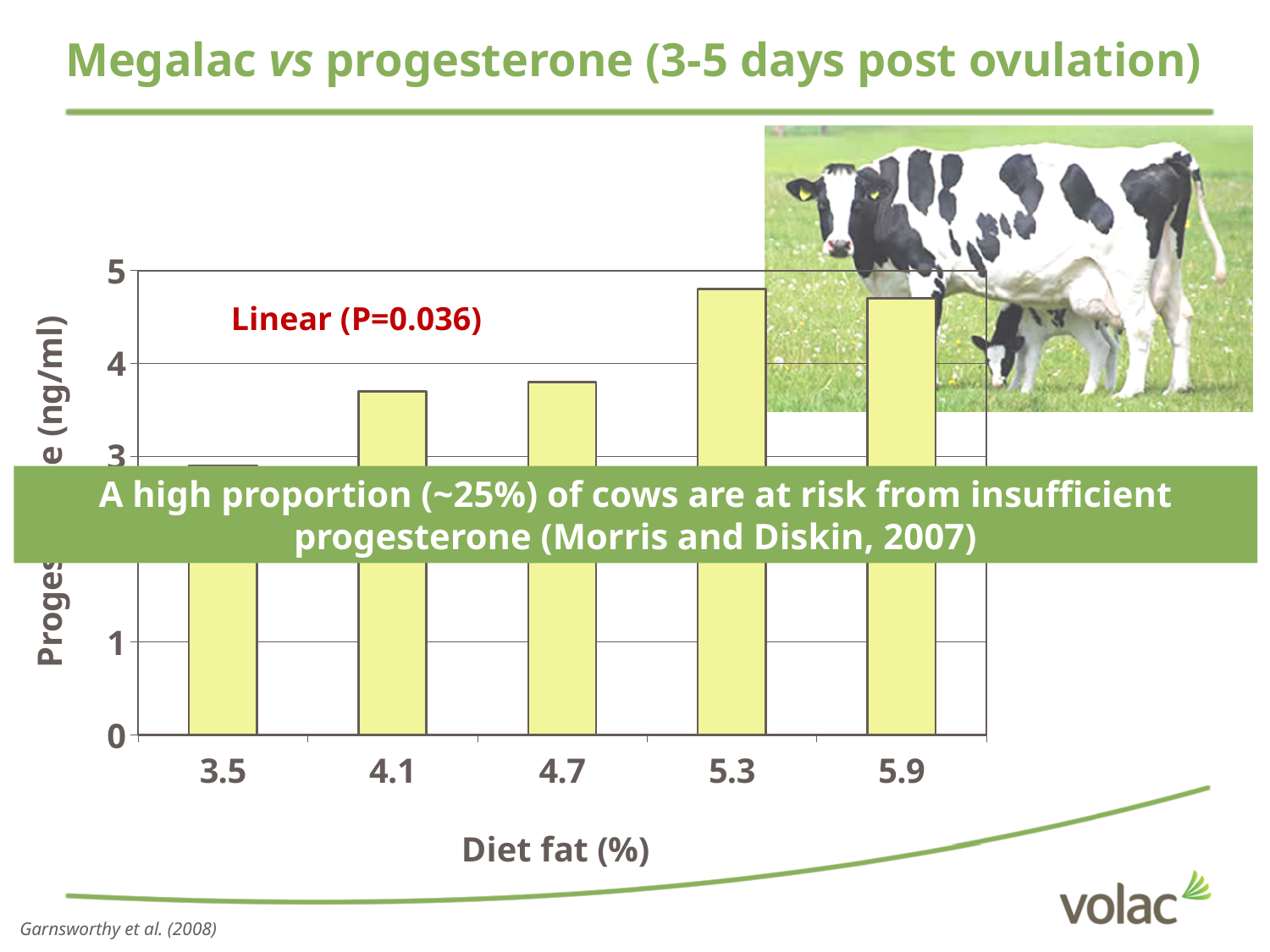
Do progesterone values generally rise or fall as diet fat increases along the x axis? rise What kind of chart is shown on the slide? bar chart Which has the higher progesterone value, diet fat 3.5% or diet fat 5.3%? 5.3 Is the progesterone value for diet fat 4.1% greater or less than 3? greater What is the title of the x axis? Diet fat (%) Is the progesterone value for diet fat 4.7% greater or less than 4? less Which diet fat level has the lowest progesterone value? 3.5 How many diet fat categories are plotted on the x axis? 5 Is the progesterone value for diet fat 5.3% greater or less than 4? greater What P value is shown in the linear annotation on the chart? P=0.036